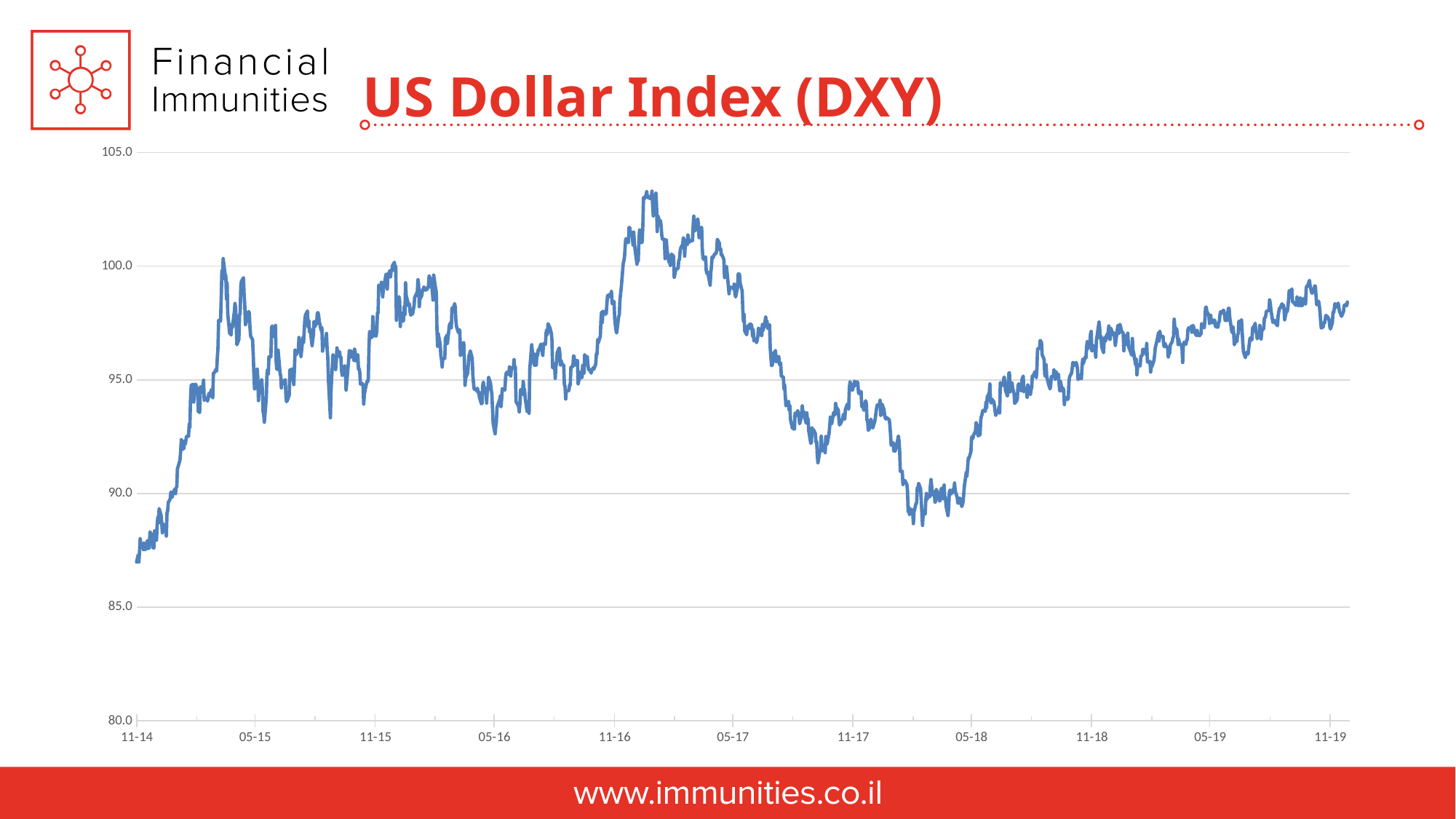
Is the value at 11-19 greater or less than 95? greater Which is higher, the value at 11-16 or the value at 11-17? 11-16 What is the title of the chart? US Dollar Index (DXY) What is the highest value shown on the y axis? 105.0 Is the value at 05-18 greater or less than 95? less Is the highest value on the chart greater or less than 100? greater Does the index rise or fall between 05-18 and 11-19? rise How many date labels are shown on the x axis? 11 Which is higher, the value at 11-14 or the value at 11-19? 11-19 What kind of chart is shown on the slide? line chart